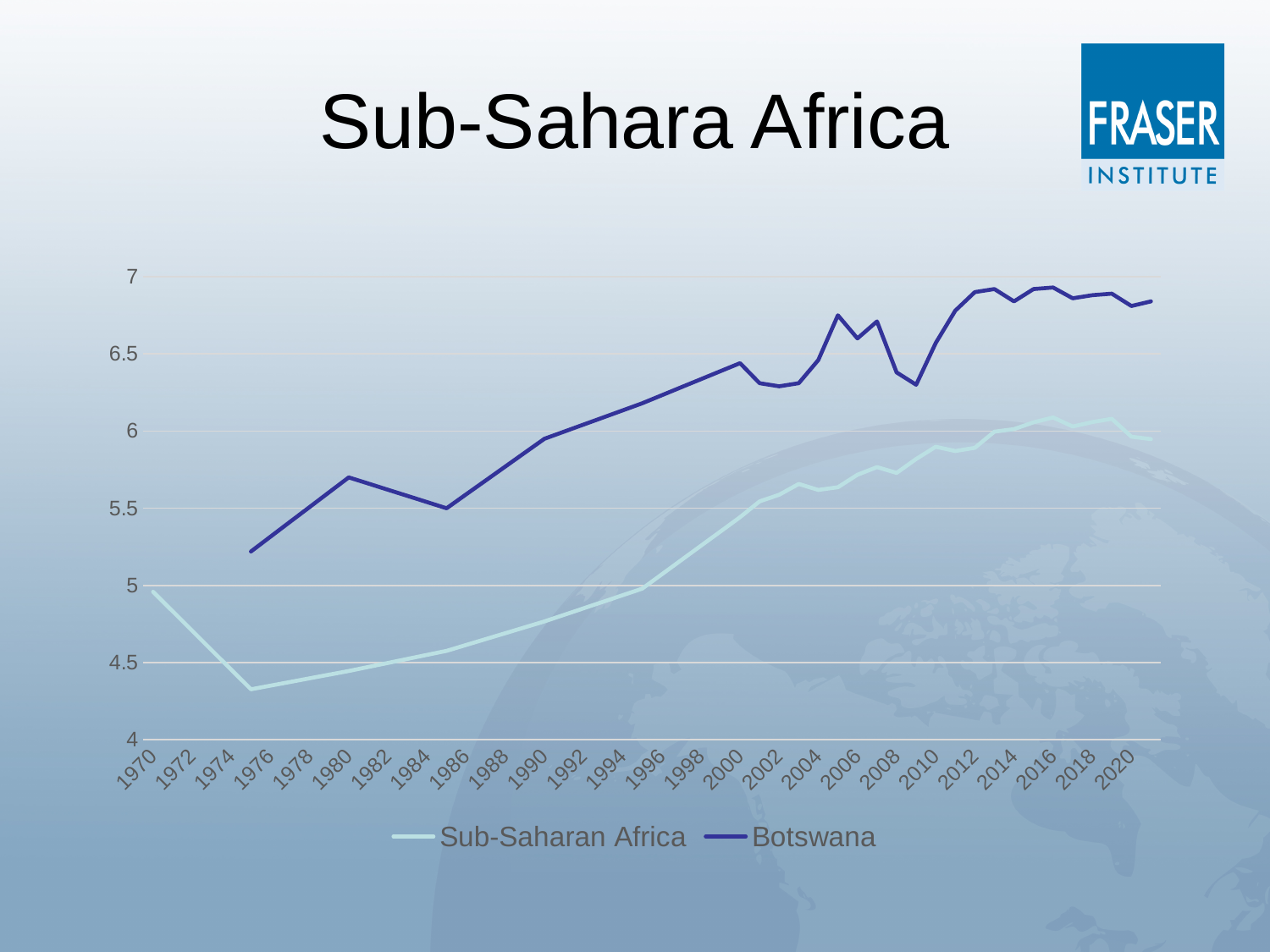
Is the value for Botswana in 2020 greater or less than 6.5? greater What kind of chart is shown on the slide? Line chart What is the title of the slide containing the chart? Sub-Sahara Africa Is the value for Botswana in 1980 greater or less than 5.5? greater What are the two series named in the legend? Sub-Saharan Africa and Botswana Which series has the higher value in 2000, Sub-Saharan Africa or Botswana? Botswana How many series does the legend list? 2 Which series reaches the highest value on the chart? Botswana Is the value for Sub-Saharan Africa in 1976 greater or less than 4.5? less How many year labels are shown on the x axis? 26 Does the Sub-Saharan Africa line rise or fall between 1976 and 2014? Rise